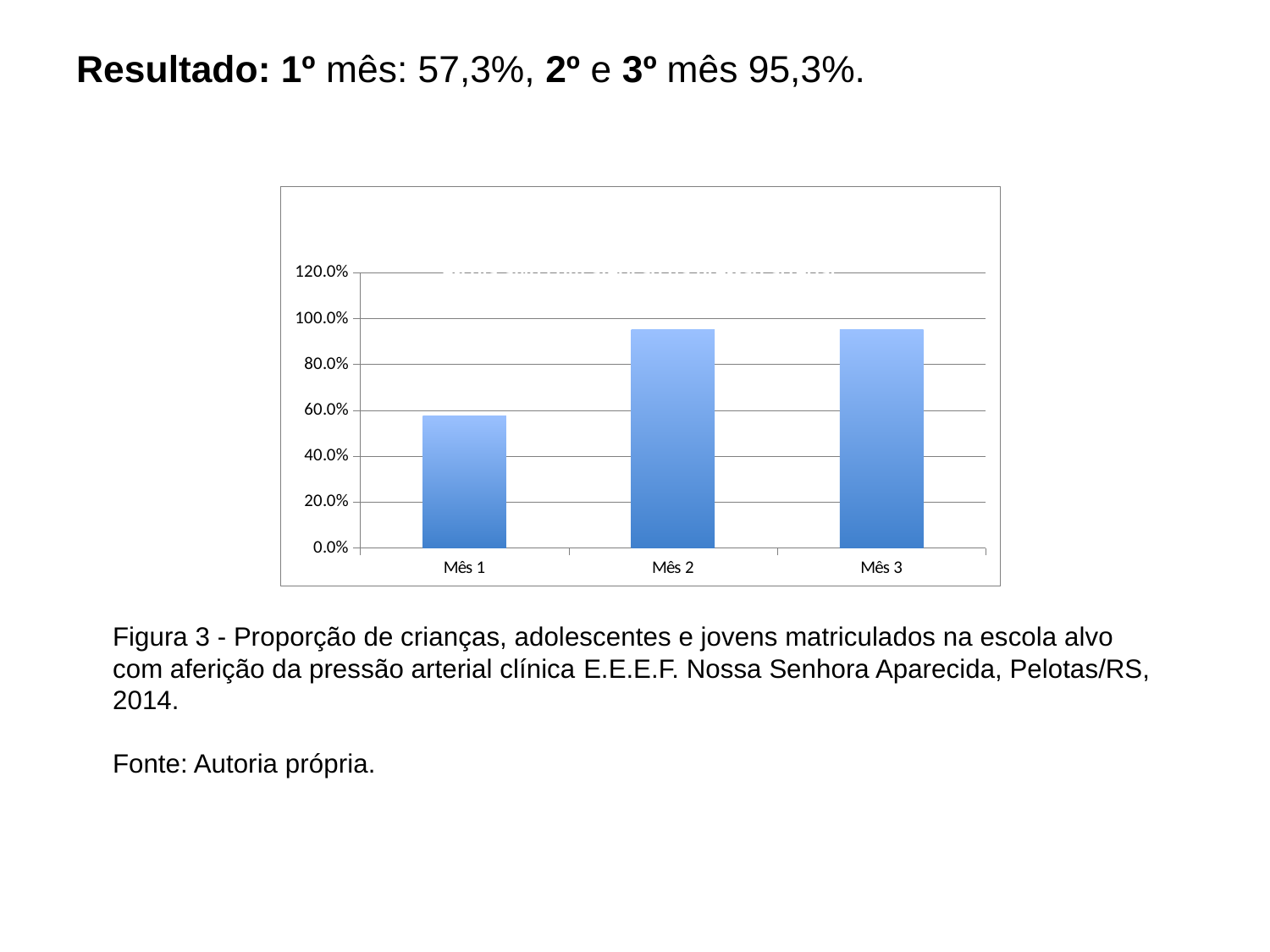
Which is larger, the value for Mês 1 or the value for Mês 2? Mês 2 How many categories (months) are plotted on the chart? 3 Does the value rise or fall from Mês 1 to Mês 2? rise According to the slide, what is the value for the 2º and 3º mês? 95,3% Is the value for Mês 2 greater or less than 80.0%? greater What is the label of the first category on the x axis? Mês 1 Is the value for Mês 1 greater or less than 40.0%? greater Is the value for Mês 3 greater or less than 100.0%? less Which month has the lowest value on the chart? Mês 1 According to the slide, what is the value for the 1º mês? 57,3% What kind of chart is shown on the slide? bar chart